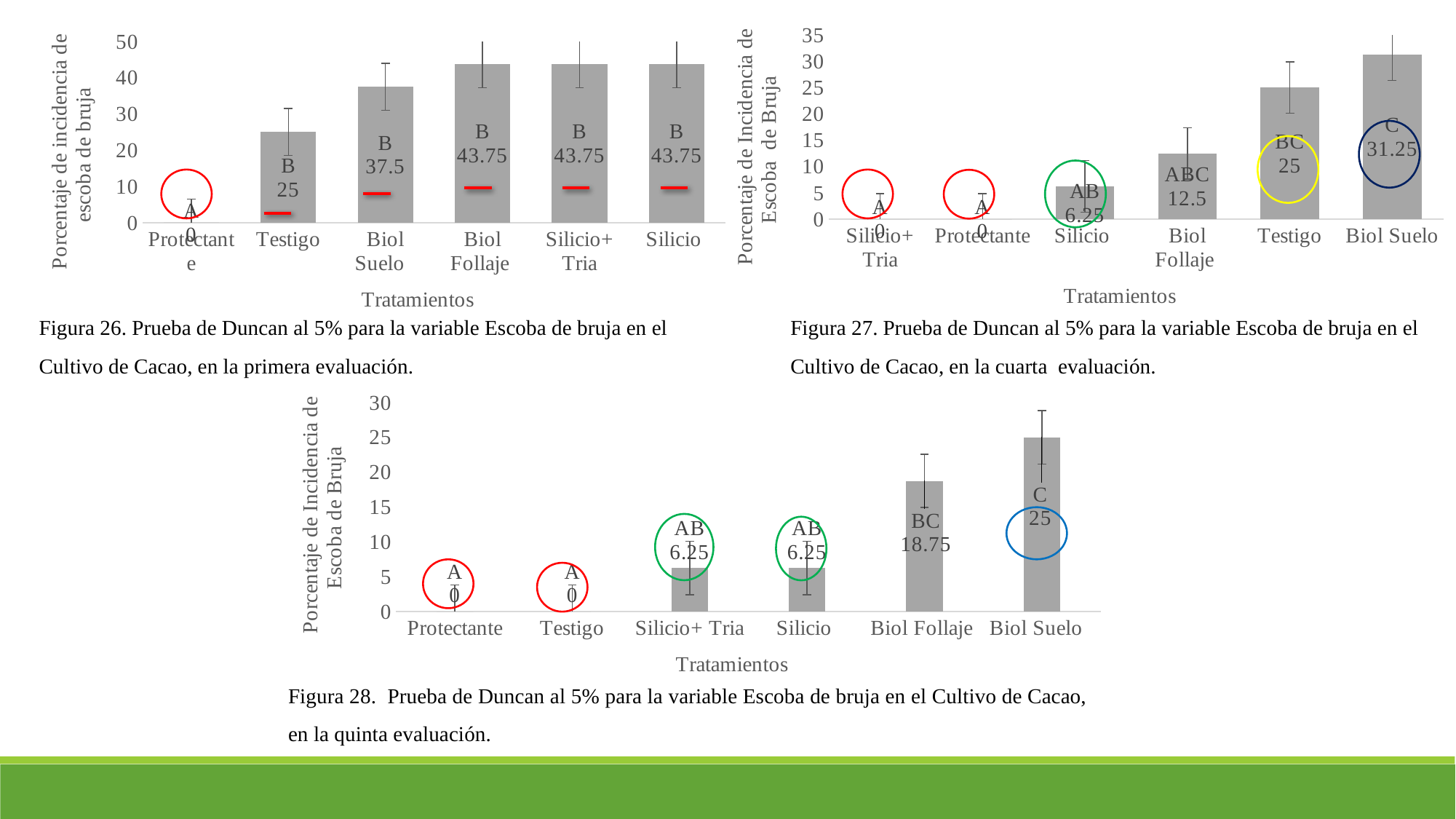
In the Figura 26 chart (top left), which treatment has the lowest value? Protectante In the Figura 27 chart (top right), how many treatments are shown on the x axis? 6 In the Figura 27 chart (top right), what is the difference between the values for Testigo and Biol Follaje? 12.5 In the Figura 26 chart (top left), what is the value for Testigo? 25 In the Figura 28 chart (bottom), which is larger, the value for Biol Suelo or the value for Biol Follaje? Biol Suelo In the Figura 27 chart (top right), what is the value for Biol Suelo? 31.25 In the Figura 26 chart (top left), what is the difference between the values for Biol Follaje and Biol Suelo? 6.25 In the Figura 28 chart (bottom), what is the value for Silicio? 6.25 In the Figura 27 chart (top right), which treatment has the highest value? Biol Suelo In the Figura 28 chart (bottom), what is the value for Biol Follaje? 18.75 What kind of chart is the Figura 28 chart (bottom)? Bar chart In the Figura 26 chart (top left), what is the value for Biol Suelo? 37.5